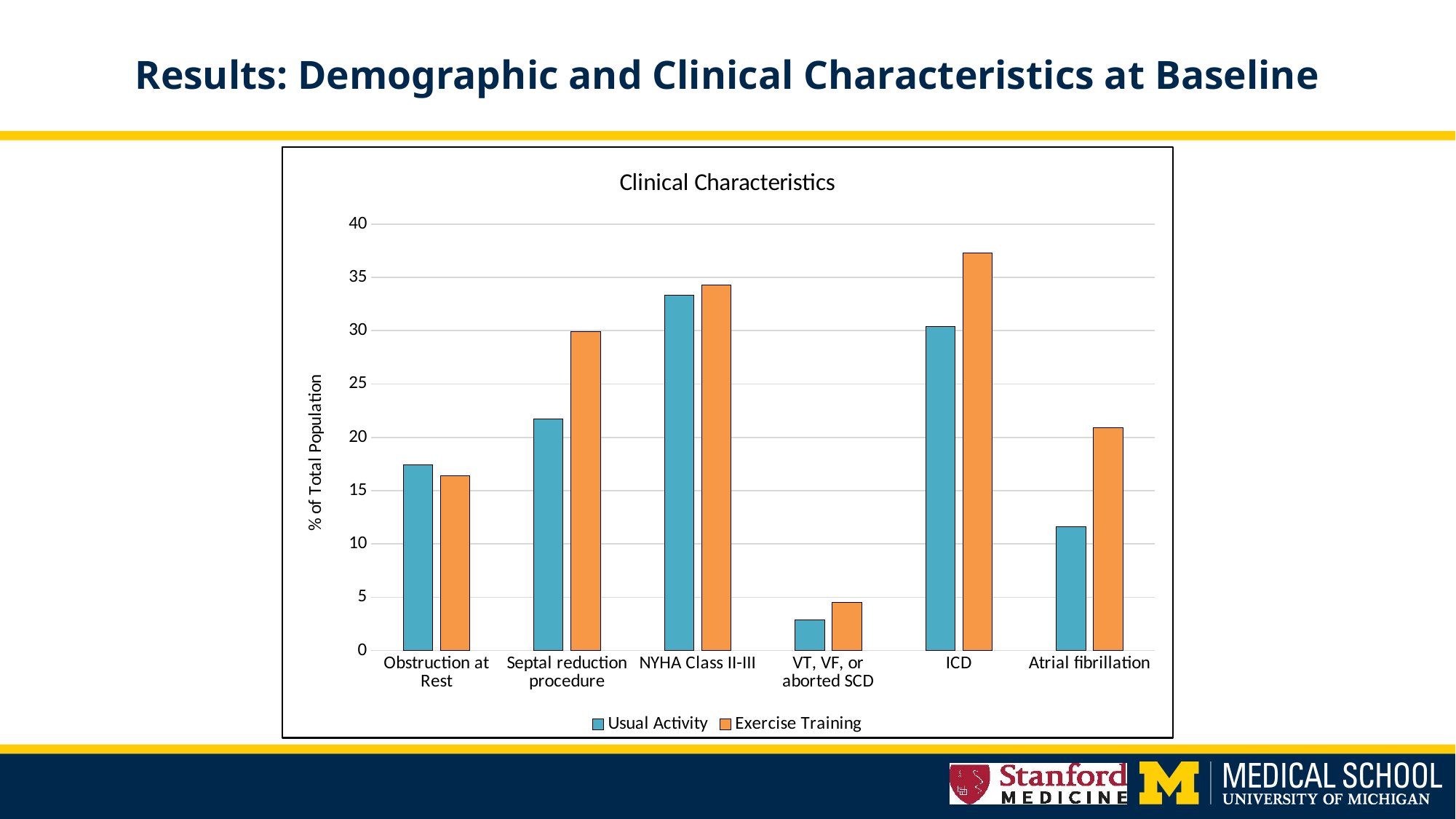
What is the title of the chart? Clinical Characteristics What kind of chart is shown on the slide? bar chart Is the Exercise Training value for ICD greater or less than 35? greater How many series does the legend list? 2 For Atrial fibrillation, which series has the larger value, Usual Activity or Exercise Training? Exercise Training Which category has the highest value for Usual Activity? NYHA Class II-III What is the label of the y axis? % of Total Population Which category has the lowest value for Exercise Training? VT, VF, or aborted SCD Is the Usual Activity value for VT, VF, or aborted SCD greater or less than 5? less Which category has the highest value for Exercise Training? ICD For Septal reduction procedure, which series has the larger value, Usual Activity or Exercise Training? Exercise Training How many categories are shown on the x axis? 6